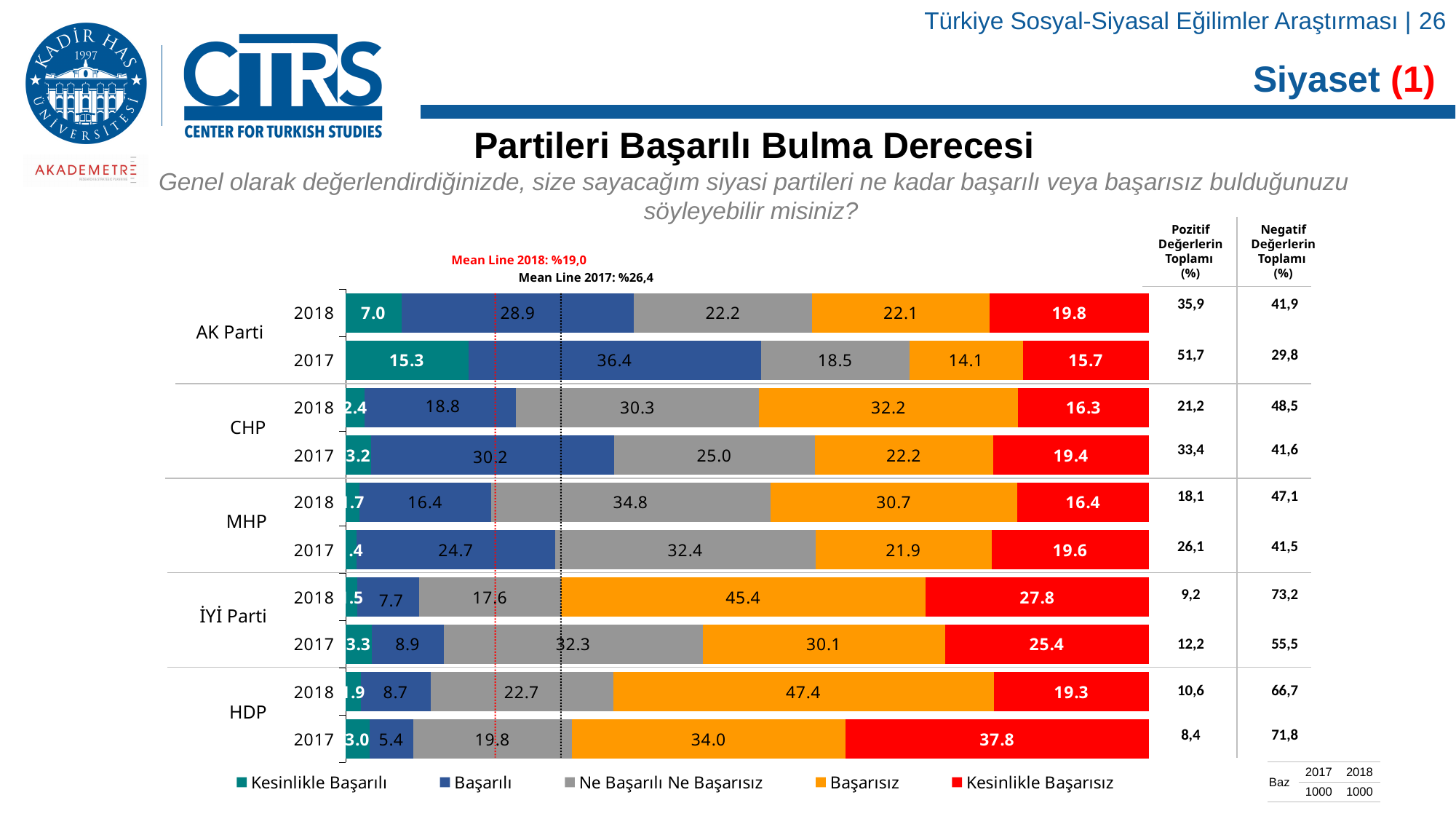
Which party and year has the highest Kesinlikle Başarısız value? HDP 2017 How many political parties are shown in the chart? 5 What is the value for Başarısız for İYİ Parti in 2018? 45.4 What is the value for Başarılı for AK Parti in 2018? 28.9 Which is larger, the Başarısız value for CHP in 2018 or for MHP in 2018? CHP 2018 What is the value for Kesinlikle Başarısız for HDP in 2017? 37.8 How many series does the legend list? 5 Did the Başarılı value for AK Parti rise or fall from 2017 to 2018? Fall Which party and year has the lowest Başarısız value? AK Parti 2017 What kind of chart is shown on the slide? Stacked bar chart What is the difference between the Kesinlikle Başarılı values for AK Parti in 2017 and 2018? 8.3 What is the value of the Mean Line for 2018 shown on the chart? %19,0